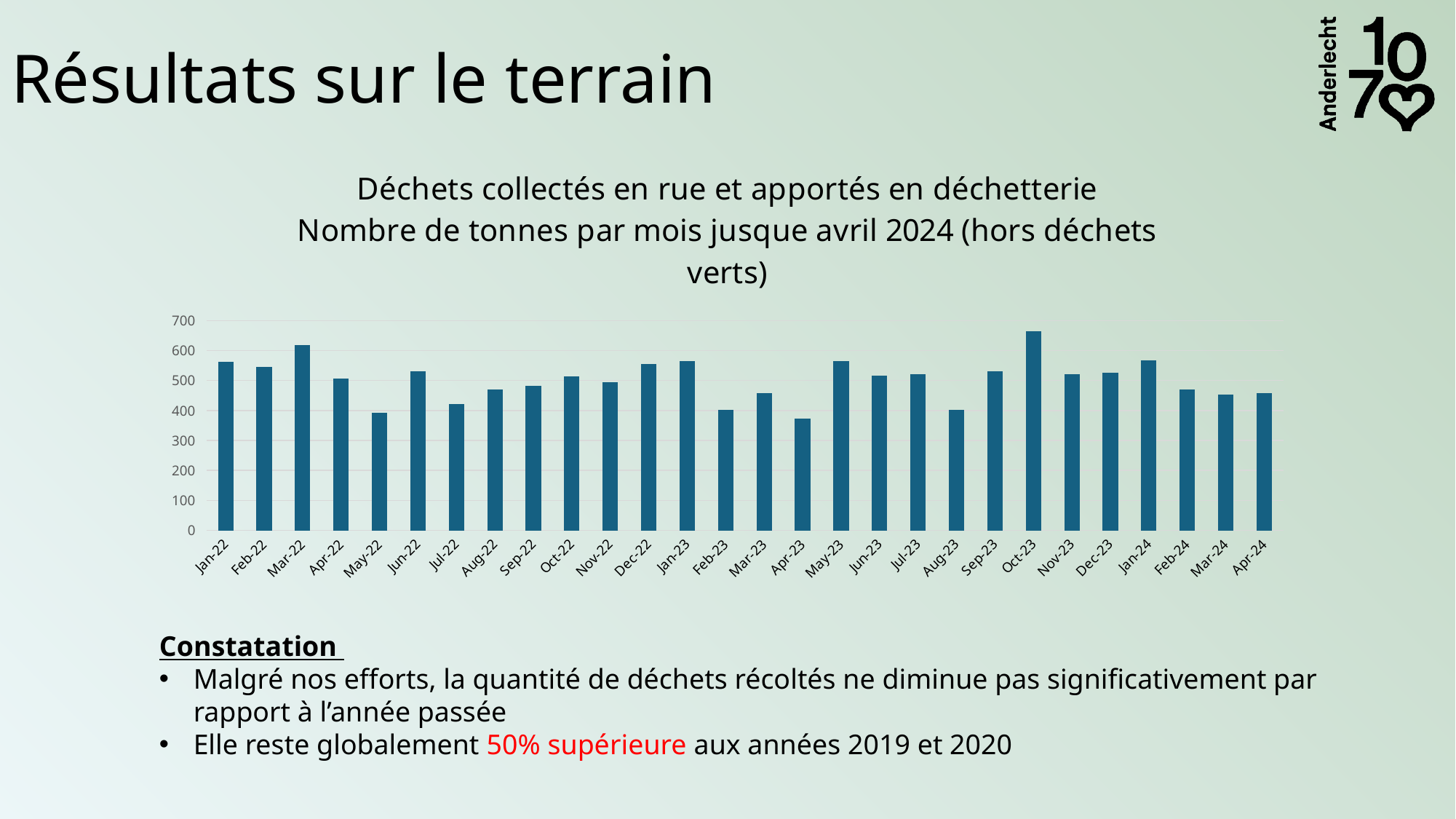
How many months (bars) are plotted in the chart? 28 Is the value for Mar-22 greater or less than 600? greater Is the value for Apr-24 greater or less than 500? less Is the value for Jan-24 greater or less than 500? greater What kind of chart is shown on the slide? bar chart Which is larger, the value for Jan-23 or the value for Feb-23? Jan-23 What is the highest value shown on the vertical axis of the chart? 700 Which month has the highest number of tonnes in the chart? Oct-23 Which is larger, the value for Mar-22 or the value for Apr-22? Mar-22